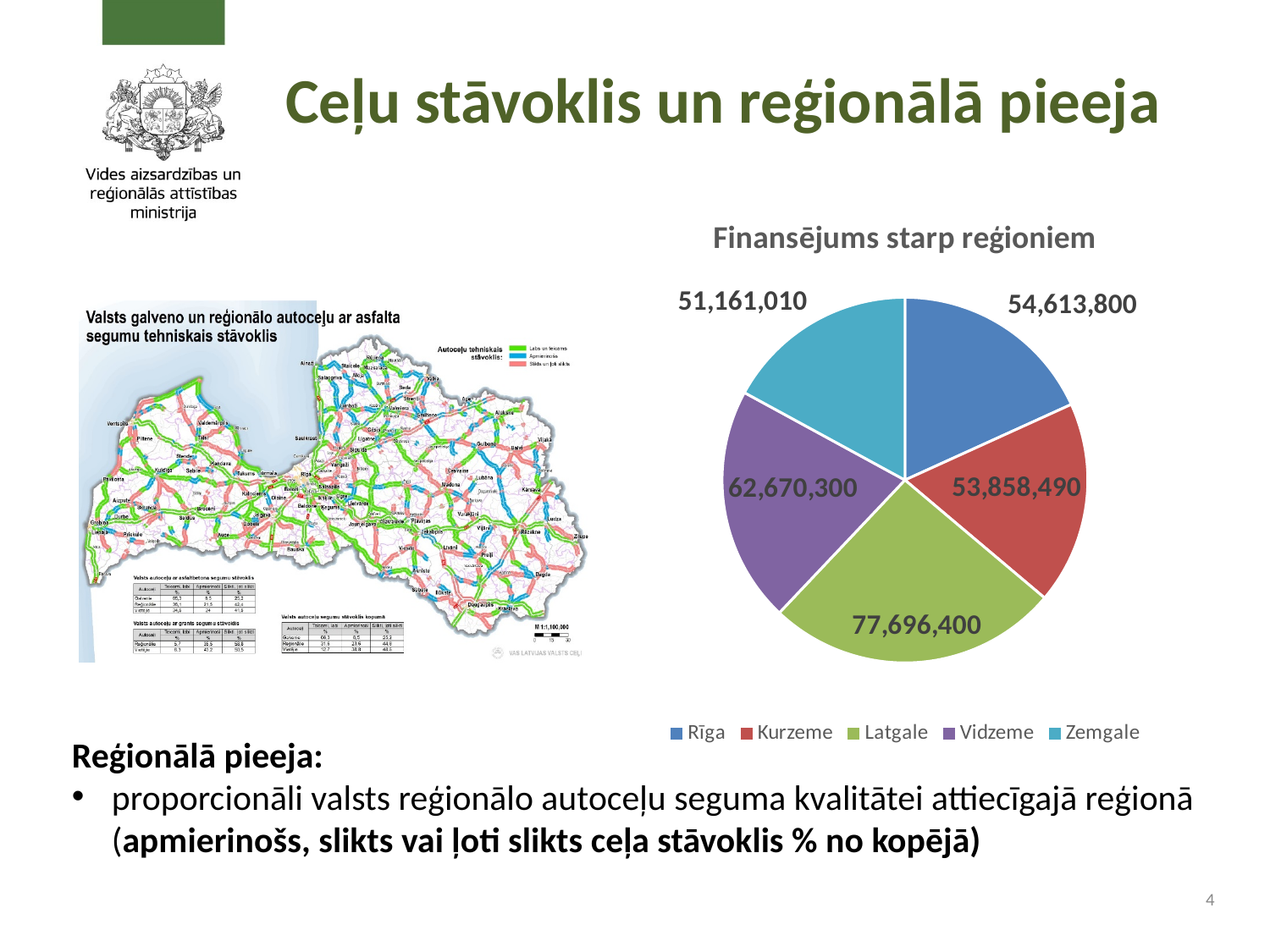
In the pie chart 'Finansējums starp reģioniem', what is the difference between the values for Latgale and Vidzeme? 15,026,100 In the pie chart 'Finansējums starp reģioniem', what is the value for Vidzeme? 62,670,300 In the pie chart 'Finansējums starp reģioniem', what is the value for Zemgale? 51,161,010 In the pie chart 'Finansējums starp reģioniem', which colour represents Kurzeme? red In the pie chart 'Finansējums starp reģioniem', what is the value for Rīga? 54,613,800 In the pie chart 'Finansējums starp reģioniem', which is larger, the value for Rīga or the value for Kurzeme? Rīga In the pie chart 'Finansējums starp reģioniem', which region has the smallest slice? Zemgale In the pie chart 'Finansējums starp reģioniem', what is the total of all slices? 300,000,000 In the pie chart 'Finansējums starp reģioniem', what is the value for Latgale? 77,696,400 What type of chart is 'Finansējums starp reģioniem'? pie chart How many slices does the pie chart 'Finansējums starp reģioniem' have? 5 In the pie chart 'Finansējums starp reģioniem', which region has the largest slice? Latgale